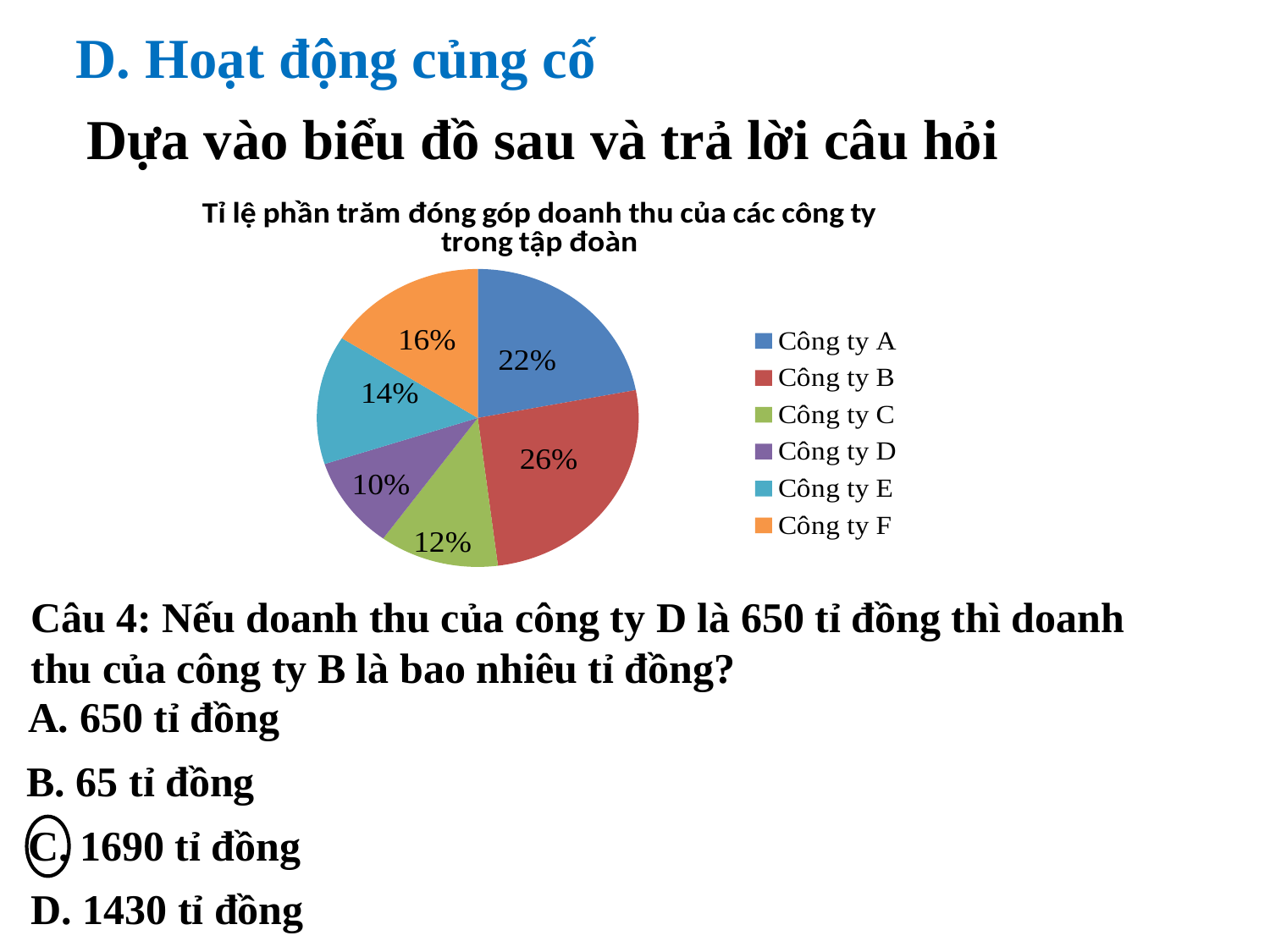
How many companies are shown in the pie chart? 6 What share of the pie does Công ty F have? 16% Which company is shown in orange in the legend? Công ty F What kind of chart is shown on the slide? Pie chart Which company has the largest slice of the pie? Công ty B What share of the pie does Công ty D have? 10% What share of the pie does Công ty B have? 26% Which has a larger share, Công ty E or Công ty F? Công ty F What is the difference in percentage points between Công ty B and Công ty C? 14% What is the title of the chart? Tỉ lệ phần trăm đóng góp doanh thu của các công ty trong tập đoàn Which company has the smallest slice of the pie? Công ty D